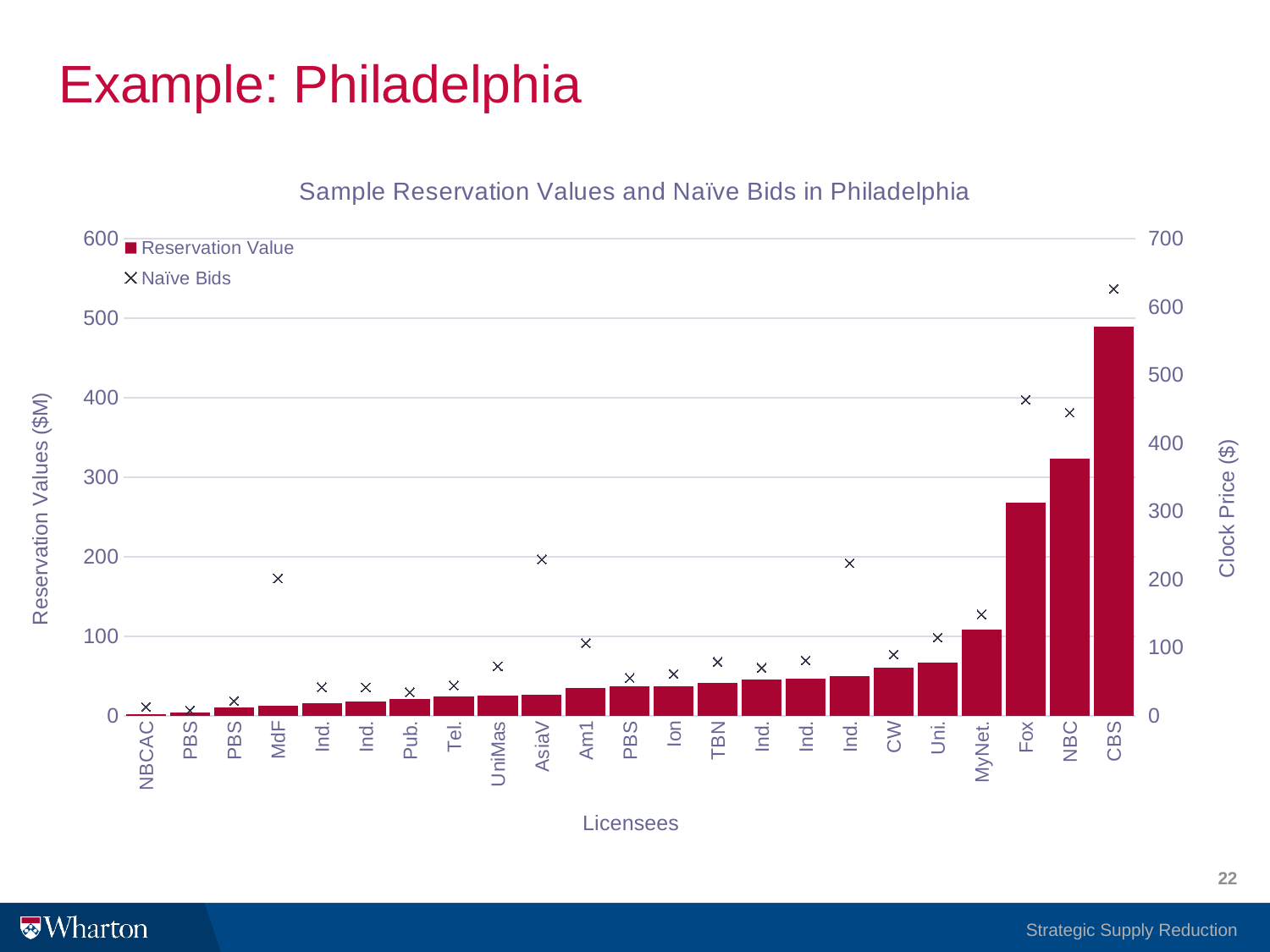
How many series does the chart legend list? 2 Is the Naïve Bid for CBS greater or less than 600 on the Clock Price axis? greater What is the title of the right-hand vertical axis? Clock Price ($) Do the Reservation Values generally rise or fall moving from left to right along the x axis? Rise What kind of chart is used to show the Reservation Value series? Bar chart Which has the larger Reservation Value, Fox or NBC? NBC Which licensee has the lowest Reservation Value? NBCAC What is the title of the chart? Sample Reservation Values and Naïve Bids in Philadelphia Is the Reservation Value for CBS greater or less than 400? greater Which licensee has the highest Reservation Value? CBS How many licensees are shown along the x axis? 23 Is the Reservation Value for Fox greater or less than 300? less